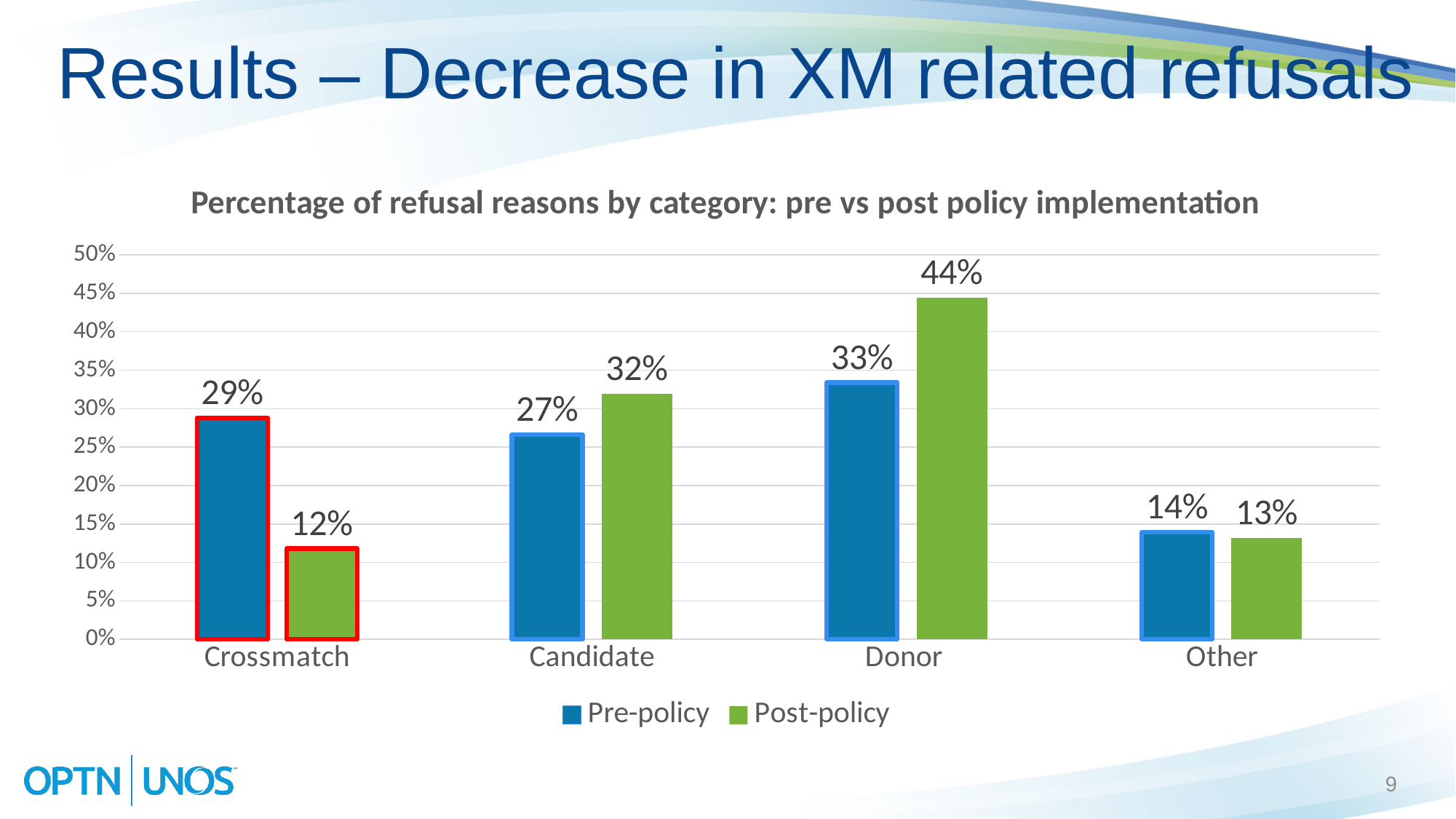
What is the difference between the Post-policy and Pre-policy values for Donor? 11% Which category has the lowest Pre-policy value? Other Which category has the highest Post-policy value? Donor What is the Post-policy value for Other? 13% Which is larger for Candidate, the Pre-policy value or the Post-policy value? Post-policy What kind of chart is shown on the slide? Bar chart What is the title of the chart? Percentage of refusal reasons by category: pre vs post policy implementation What is the Pre-policy value for Crossmatch? 29% What is the difference between the Pre-policy and Post-policy values for Crossmatch? 17% What is the Post-policy value for Donor? 44% How many categories are shown on the x axis? 4 How many series does the legend list? 2